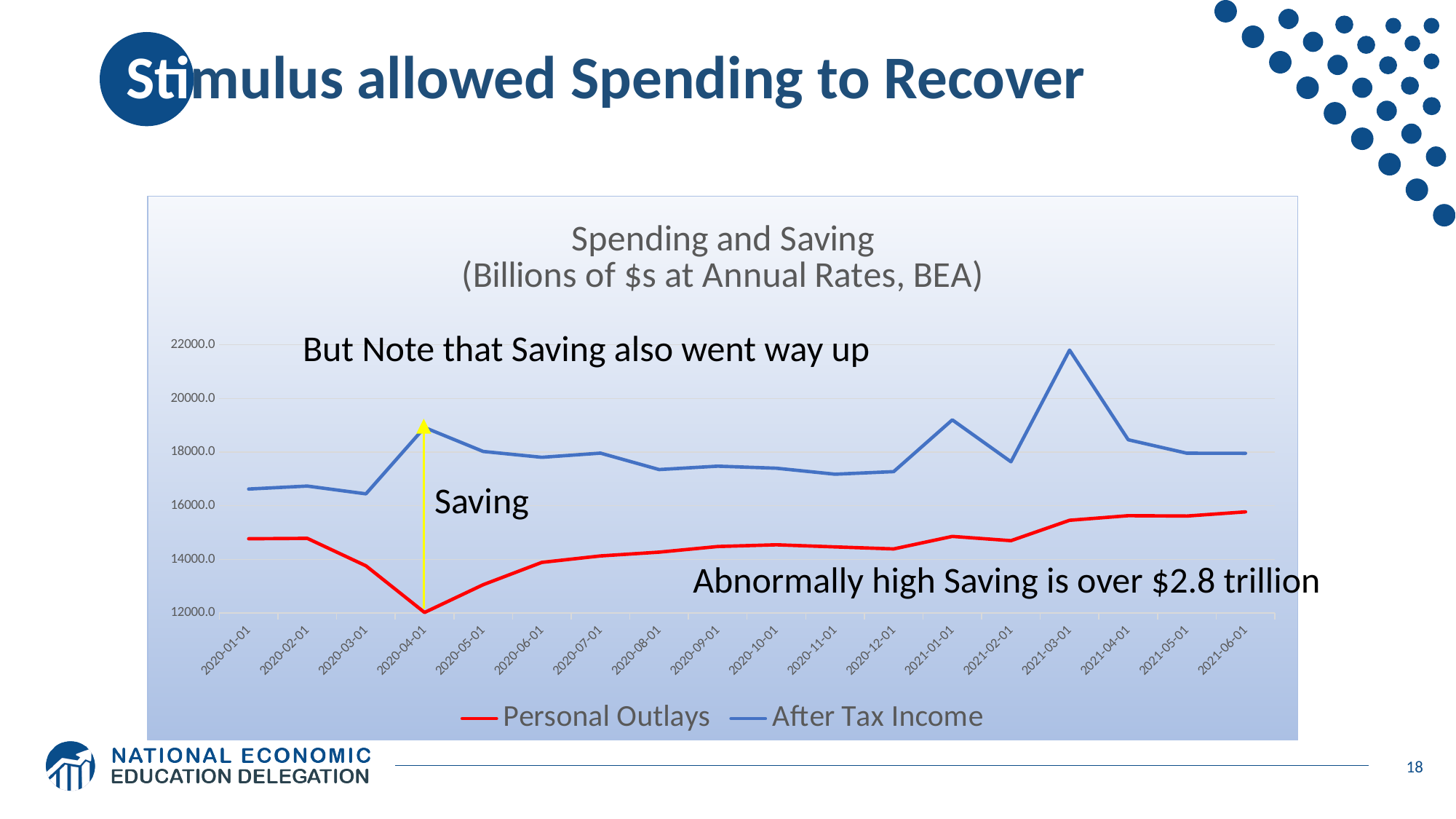
On which date does After Tax Income reach its highest value? 2021-03-01 Is the value for After Tax Income on 2021-03-01 greater or less than 20000.0? greater On 2020-06-01, which is larger: Personal Outlays or After Tax Income? After Tax Income What kind of chart is shown on the slide? Line chart On which date do Personal Outlays reach their lowest value? 2020-04-01 Is the value for Personal Outlays on 2020-01-01 greater or less than 16000.0? less Is the value for Personal Outlays on 2020-04-01 greater or less than 14000.0? less How many series does the legend list? 2 Which colour is used for the After Tax Income line? Blue How many dates are shown on the x axis of the chart? 18 Do Personal Outlays rise or fall from 2020-04-01 to 2021-06-01? Rise